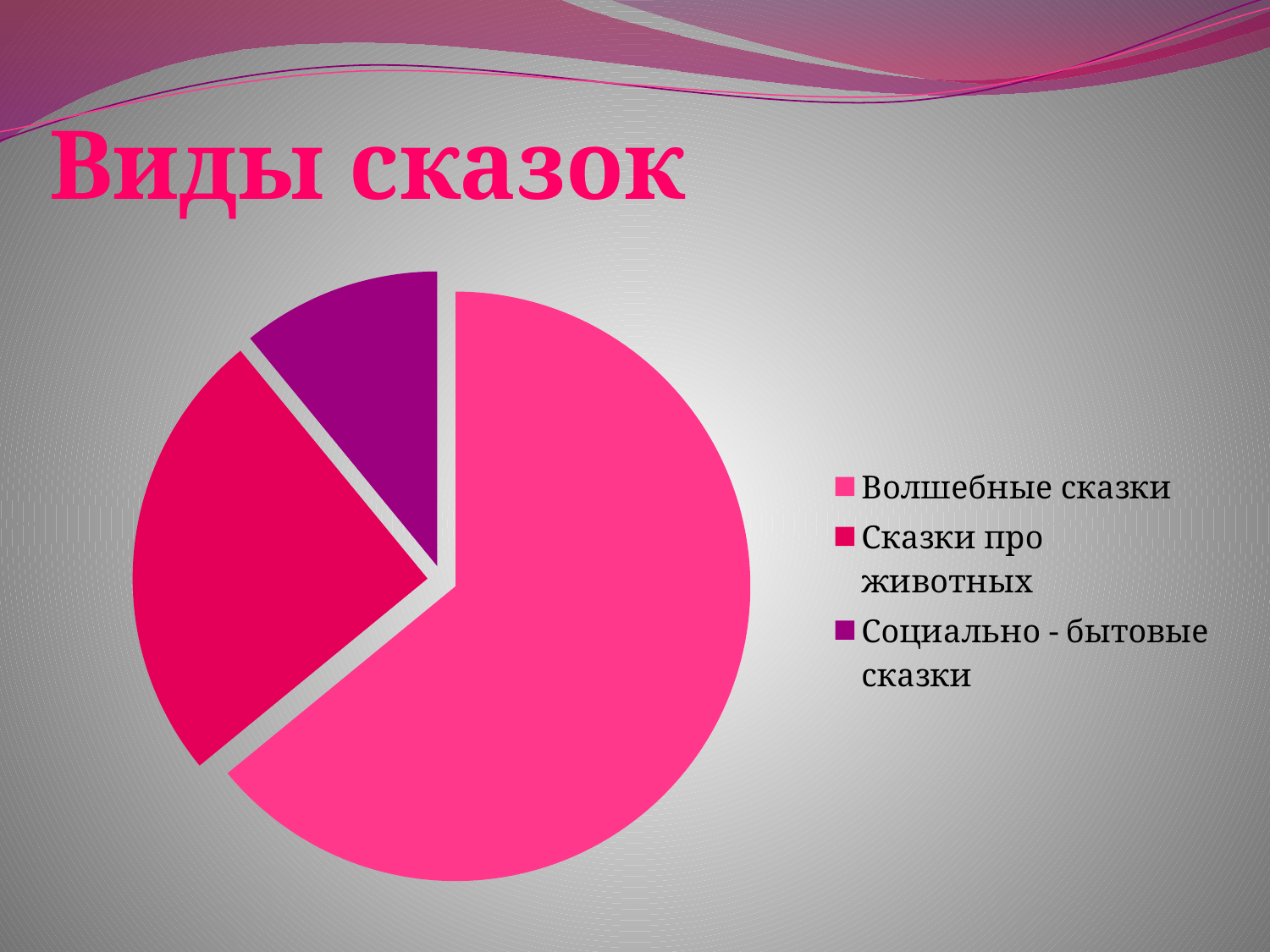
Which slice is larger: Волшебные сказки or Сказки про животных? Волшебные сказки What colour is the slice for Социально - бытовые сказки? Purple What kind of chart is shown on the slide? Pie chart Does the Волшебные сказки slice take up more or less than half of the pie? More Which category has the largest slice of the pie chart? Волшебные сказки How many slices does the pie chart have? 3 Which category has the smallest slice of the pie chart? Социально - бытовые сказки How many entries does the legend of the pie chart list? 3 What is the title of the slide containing the pie chart? Виды сказок Which slice is larger: Сказки про животных or Социально - бытовые сказки? Сказки про животных